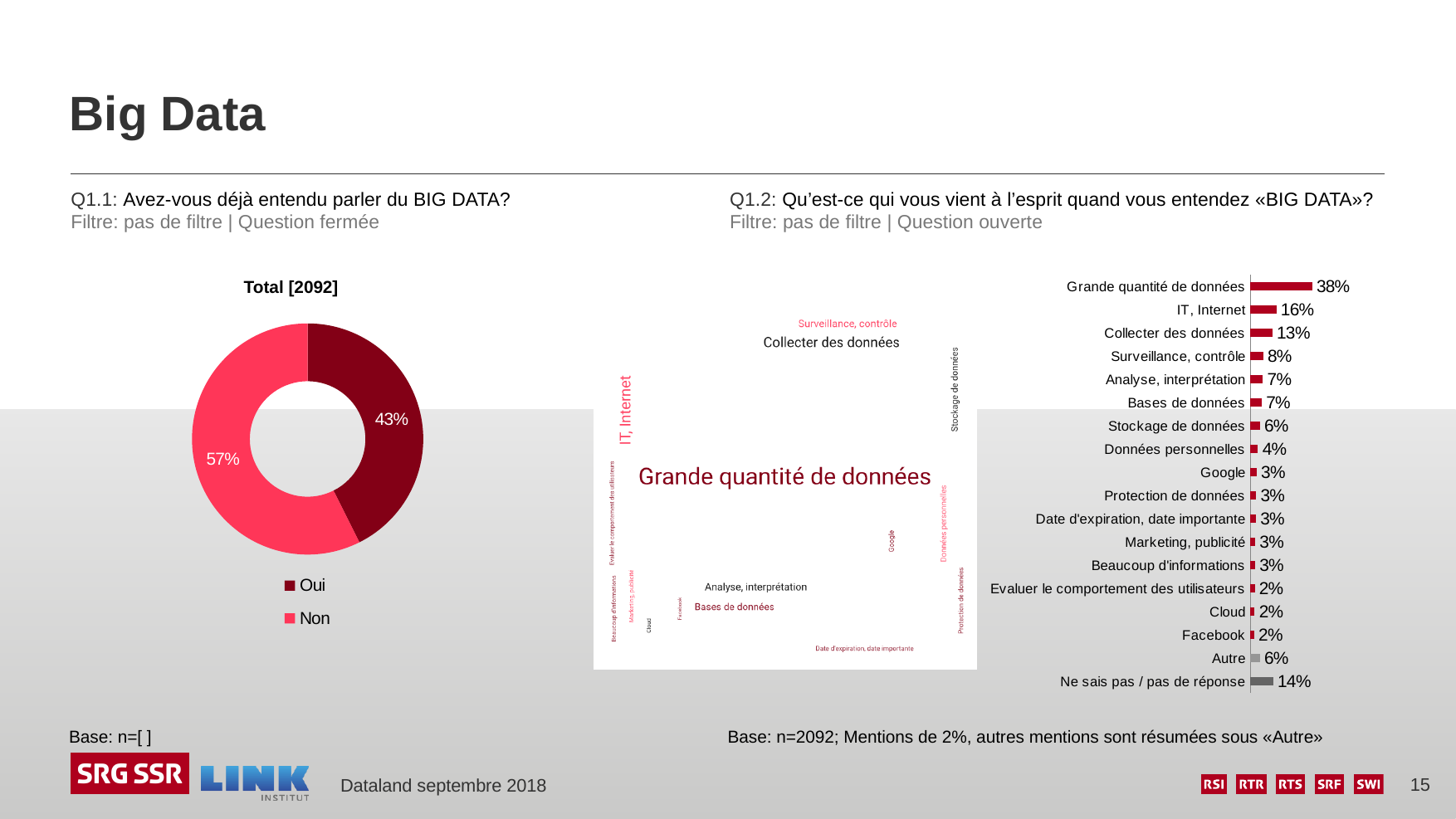
In the donut chart titled 'Total [2092]', what percentage answered 'Oui'? 43% In the donut chart titled 'Total [2092]', what is the difference in percentage points between 'Non' and 'Oui'? 14 What kind of chart is the chart on the right of the slide (Q1.2)? Bar chart In the bar chart on the right (Q1.2), what is the difference between 'IT, Internet' and 'Collecter des données'? 3% What kind of chart is the chart titled 'Total [2092]' on the left of the slide? Donut chart How many entries does the legend of the donut chart titled 'Total [2092]' list? 2 In the donut chart titled 'Total [2092]', which answer has the larger share, 'Oui' or 'Non'? Non In the bar chart on the right (Q1.2), which category has the highest value? Grande quantité de données In the bar chart on the right (Q1.2), what is the value for 'Grande quantité de données'? 38% How many categories are shown in the bar chart on the right (Q1.2)? 18 In the bar chart on the right (Q1.2), what is the value for 'Ne sais pas / pas de réponse'? 14% In the donut chart titled 'Total [2092]', what percentage answered 'Non'? 57%